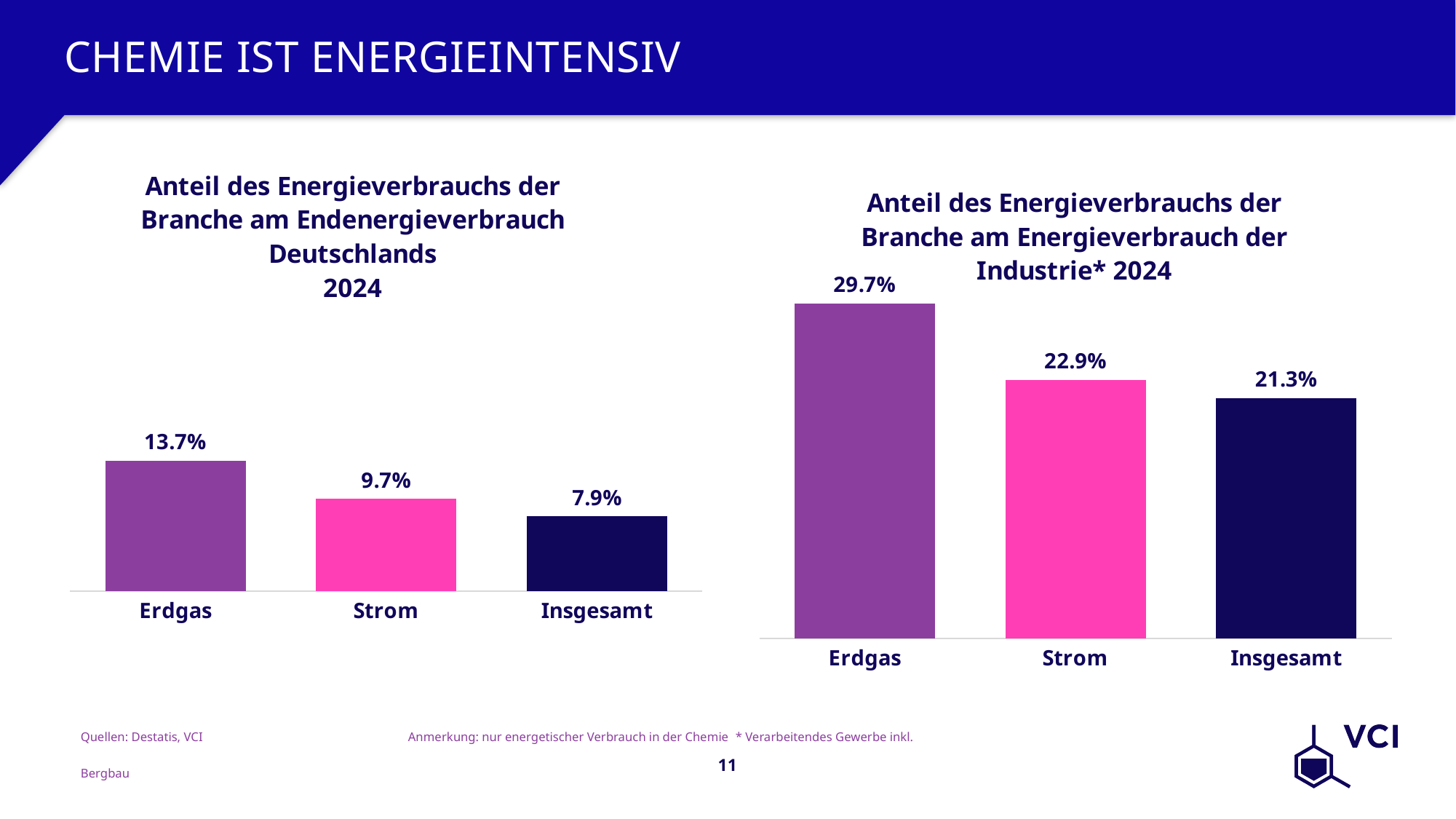
In the left chart (Anteil des Energieverbrauchs der Branche am Endenergieverbrauch Deutschlands 2024), what is the value for Erdgas? 13.7% How many categories are shown in the right chart (Energieverbrauch der Industrie* 2024)? 3 In the left chart (Endenergieverbrauch Deutschlands 2024), what is the value for Strom? 9.7% In the right chart (Anteil des Energieverbrauchs der Branche am Energieverbrauch der Industrie* 2024), what is the value for Insgesamt? 21.3% In the left chart (Endenergieverbrauch Deutschlands 2024), what is the difference between the values for Erdgas and Insgesamt? 5.8% In the left chart (Endenergieverbrauch Deutschlands 2024), which category has the highest value? Erdgas In the right chart (Energieverbrauch der Industrie* 2024), what is the difference between the values for Erdgas and Strom? 6.8% In the right chart (Energieverbrauch der Industrie* 2024), which category has the lowest value? Insgesamt In the left chart (Endenergieverbrauch Deutschlands 2024), do the values rise or fall from Erdgas to Insgesamt? Fall In the right chart (Energieverbrauch der Industrie* 2024), what is the value for Erdgas? 29.7% Is the value for Strom larger in the left chart (Endenergieverbrauch Deutschlands 2024) or in the right chart (Energieverbrauch der Industrie* 2024)? Right chart What kind of chart is the left chart (Endenergieverbrauch Deutschlands 2024)? Bar chart